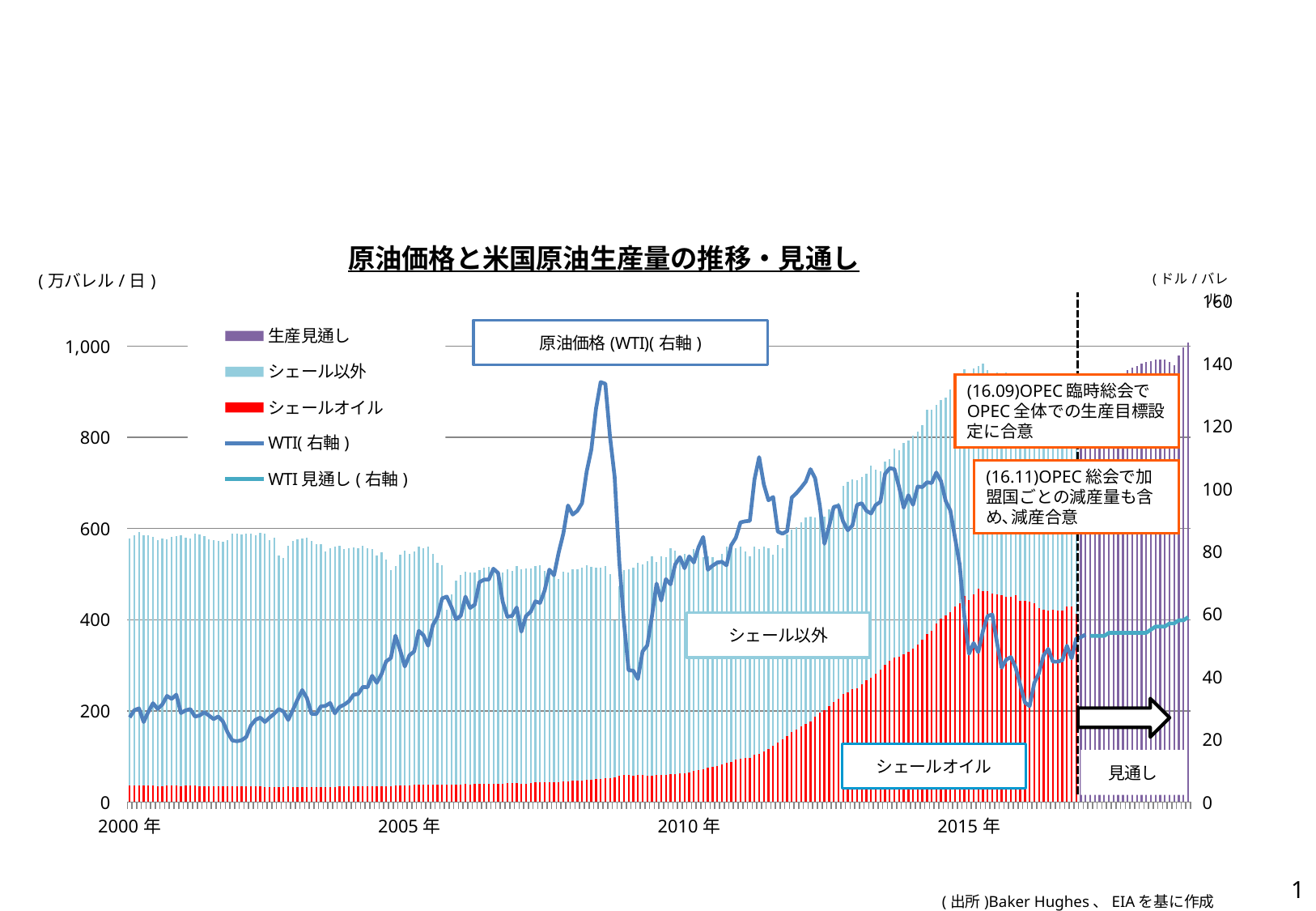
What kind of chart is this? A combined bar and line chart Does the シェールオイル series rise or fall between 2010 and 2015? rise Does the WTI line rise or fall between 2014 and early 2016? fall Is the シェールオイル value in 2000 greater or less than 200? less What unit is shown on the left axis? 万バレル/日 What is the title of the chart? 原油価格と米国原油生産量の推移・見通し Is the シェールオイル value in 2015 greater or less than 200? greater Which series is plotted in red? シェールオイル Is the total stacked bar height in 2000 greater or less than 400? greater How many series does the legend list? 5